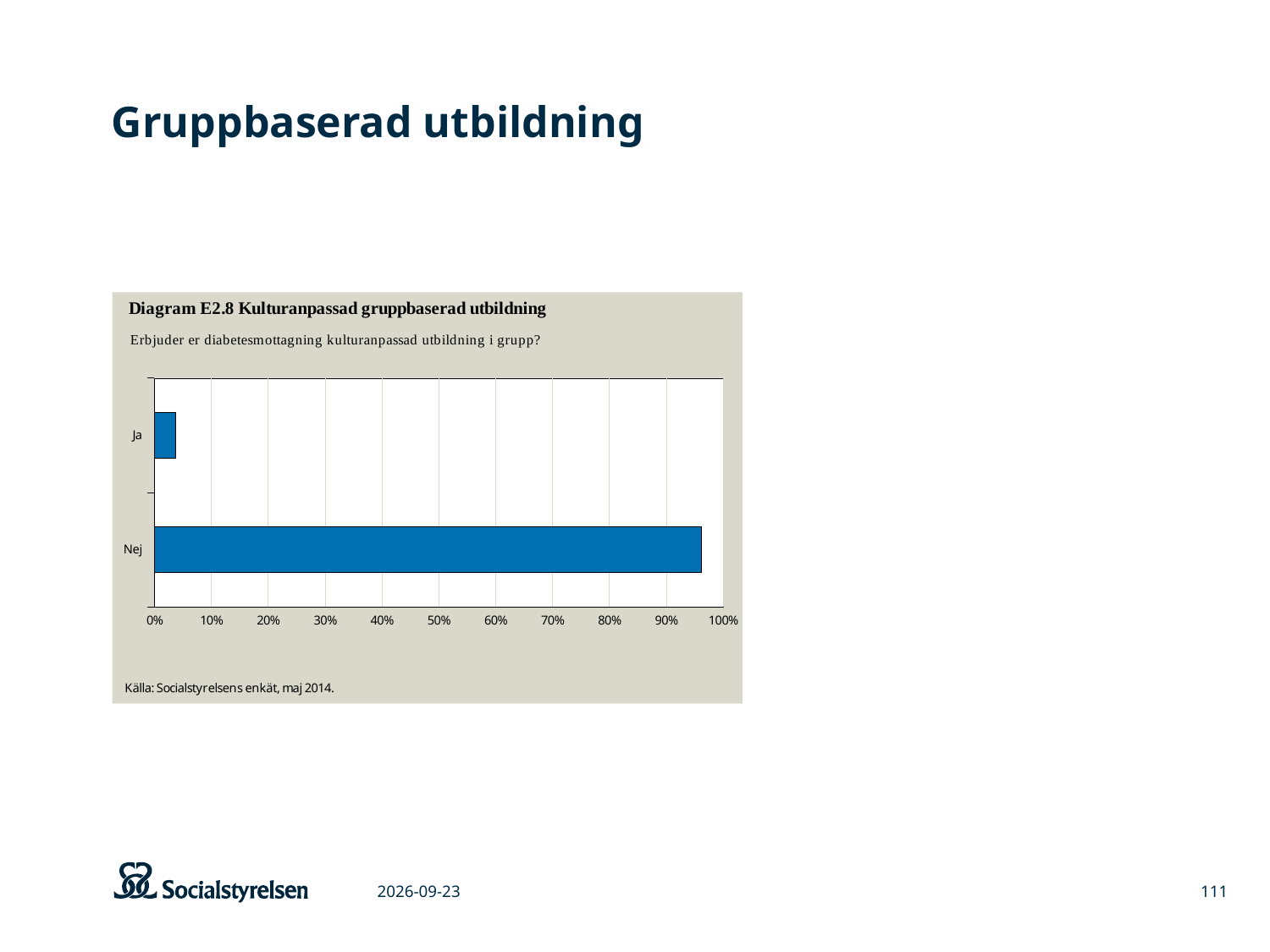
Is the value for Nej greater or less than 90%? greater How many categories are plotted in the chart? 2 What is the title of the diagram shown on the slide? Diagram E2.8 Kulturanpassad gruppbaserad utbildning Which category has the lowest value in the chart? Ja What kind of chart is shown on the slide? bar chart Which is larger, the value for Ja or the value for Nej? Nej Which category has the highest value in the chart? Nej What is the highest value shown on the horizontal axis of the chart? 100% Is the value for Ja greater or less than 10%? less Is the value for Nej greater or less than 50%? greater